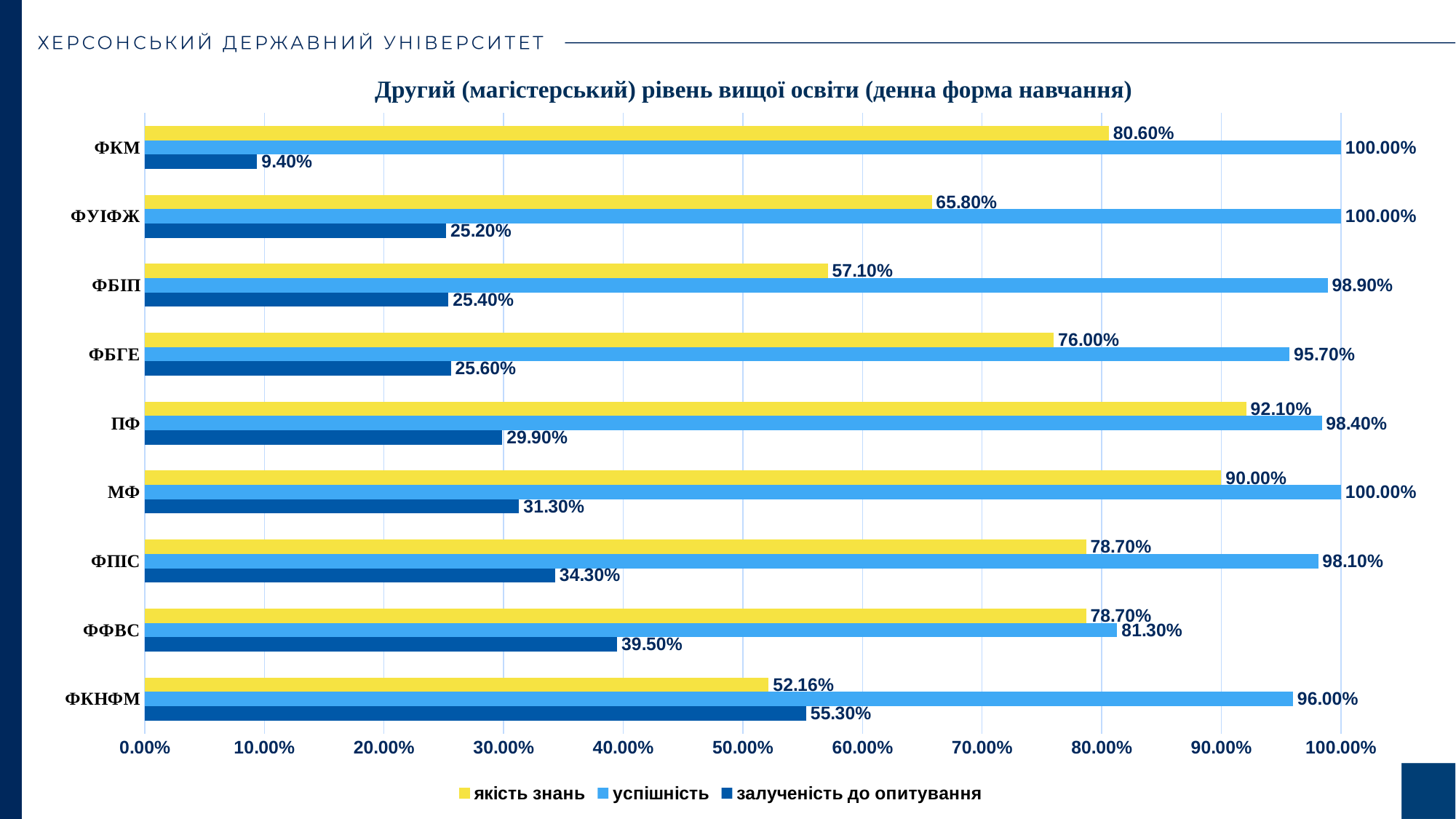
What is the difference between 'успішність' and 'якість знань' for ФКМ? 19.40% Is the value of 'залученість до опитування' for ФФВС greater or less than 30.00%? greater Which faculty has the lowest value for 'якість знань'? ФКНФМ What is the value of 'якість знань' for ПФ? 92.10% How many faculties (categories) are shown on the chart? 9 Which is larger: 'якість знань' for МФ or 'якість знань' for ФБГЕ? МФ What is the title of the chart? Другий (магістерський) рівень вищої освіти (денна форма навчання) How many series does the legend list? 3 Which faculty has the highest value for 'залученість до опитування'? ФКНФМ What type of chart is shown on the slide? bar chart What is the value of 'успішність' for ФФВС? 81.30% What is the value of 'залученість до опитування' for ФКМ? 9.40%